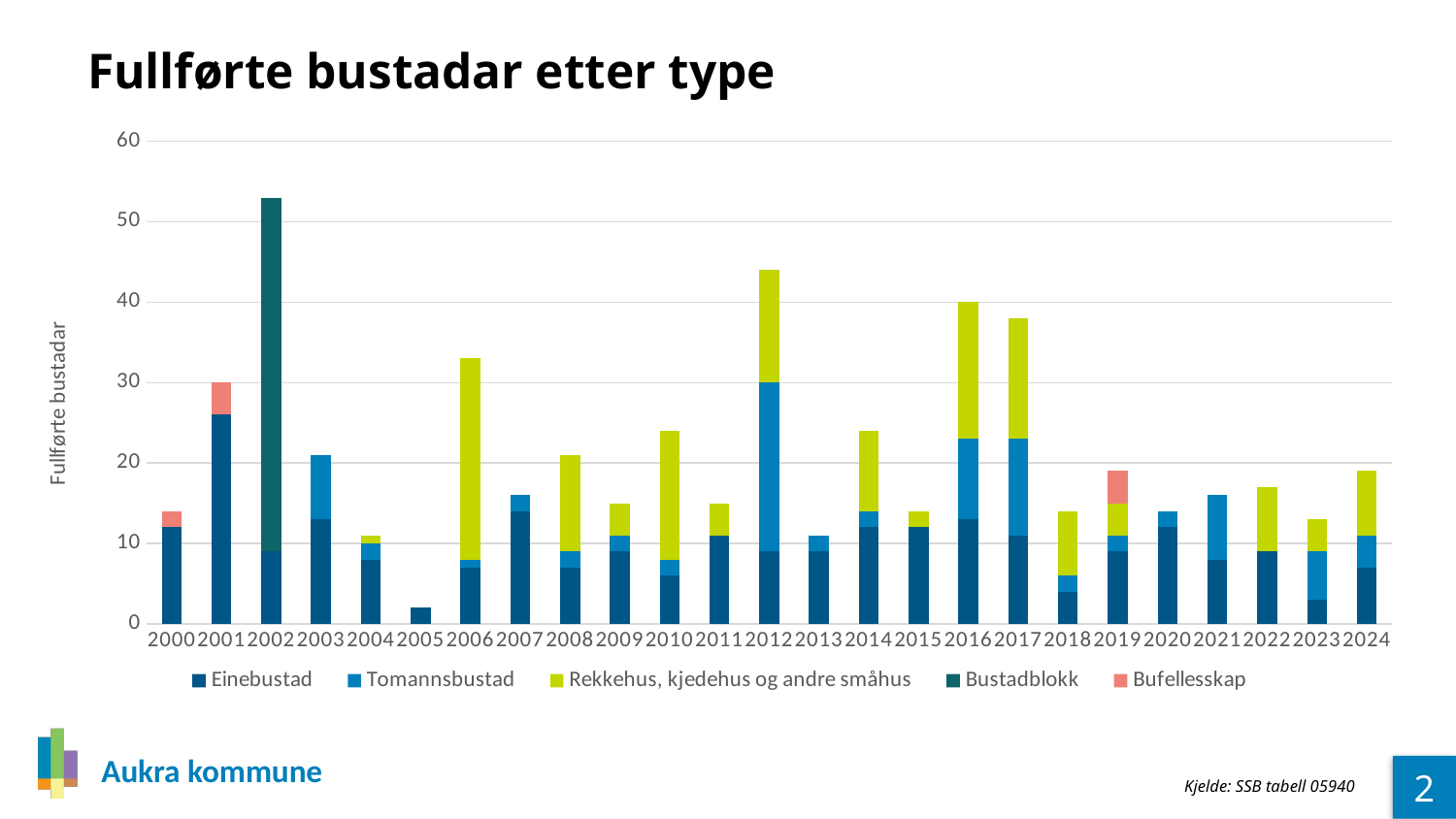
Is the total value for 2006 greater or less than 30? greater How many series does the legend list? 5 Which year has a larger total bar, 2002 or 2012? 2002 What kind of chart is shown on the slide? Stacked bar chart Which year has the highest total bar? 2002 Is the total value for 2012 greater or less than 40? greater Which year has the lowest total bar? 2005 How many years are shown along the x axis? 25 Is the total value for 2002 greater or less than 50? greater Do the total bars rise or fall from 2016 to 2018? fall What is the title of the chart? Fullførte bustadar etter type